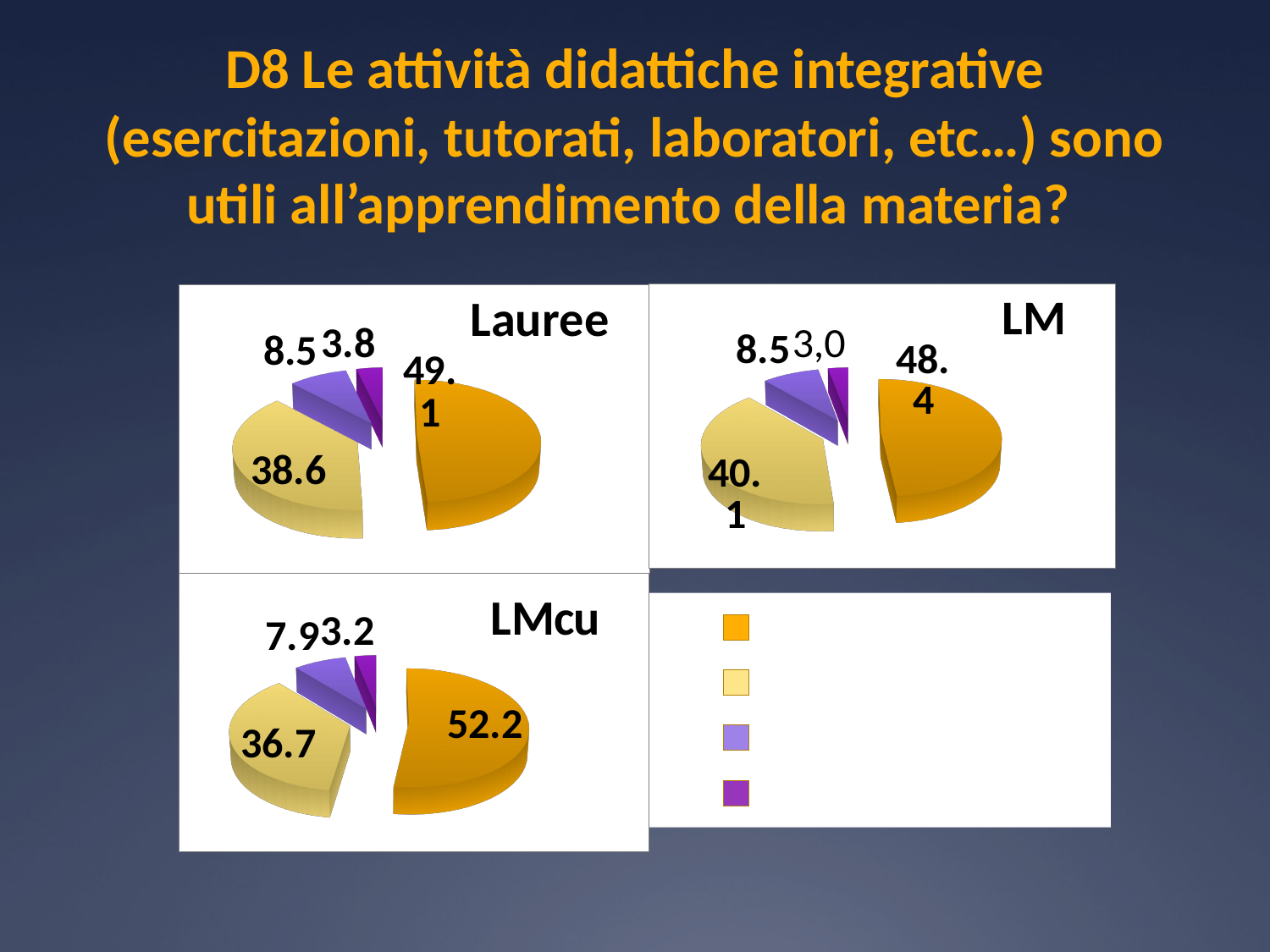
In the "LMcu" chart, what is the value of the largest slice? 52.2 How many slices does the "LM" pie chart have? 4 In the "LM" chart, what value is shown on the light yellow slice? 40.1 What are the titles of the three pie charts on the slide? Lauree, LM, LMcu What kind of chart is the "Lauree" chart? pie chart In the "LMcu" chart, what value is shown on the dark purple slice? 3.2 In the "Lauree" chart, what is the difference between the orange slice (49.1) and the light yellow slice (38.6)? 10.5 In the "LM" chart, what is the value of the smallest slice? 3,0 In the "Lauree" chart, what value is shown on the largest (orange) slice? 49.1 Which chart has the larger orange slice, "Lauree" or "LMcu"? LMcu In the "LMcu" chart, what value is shown on the lavender (light purple) slice? 7.9 How many pie charts are shown on the slide? 3